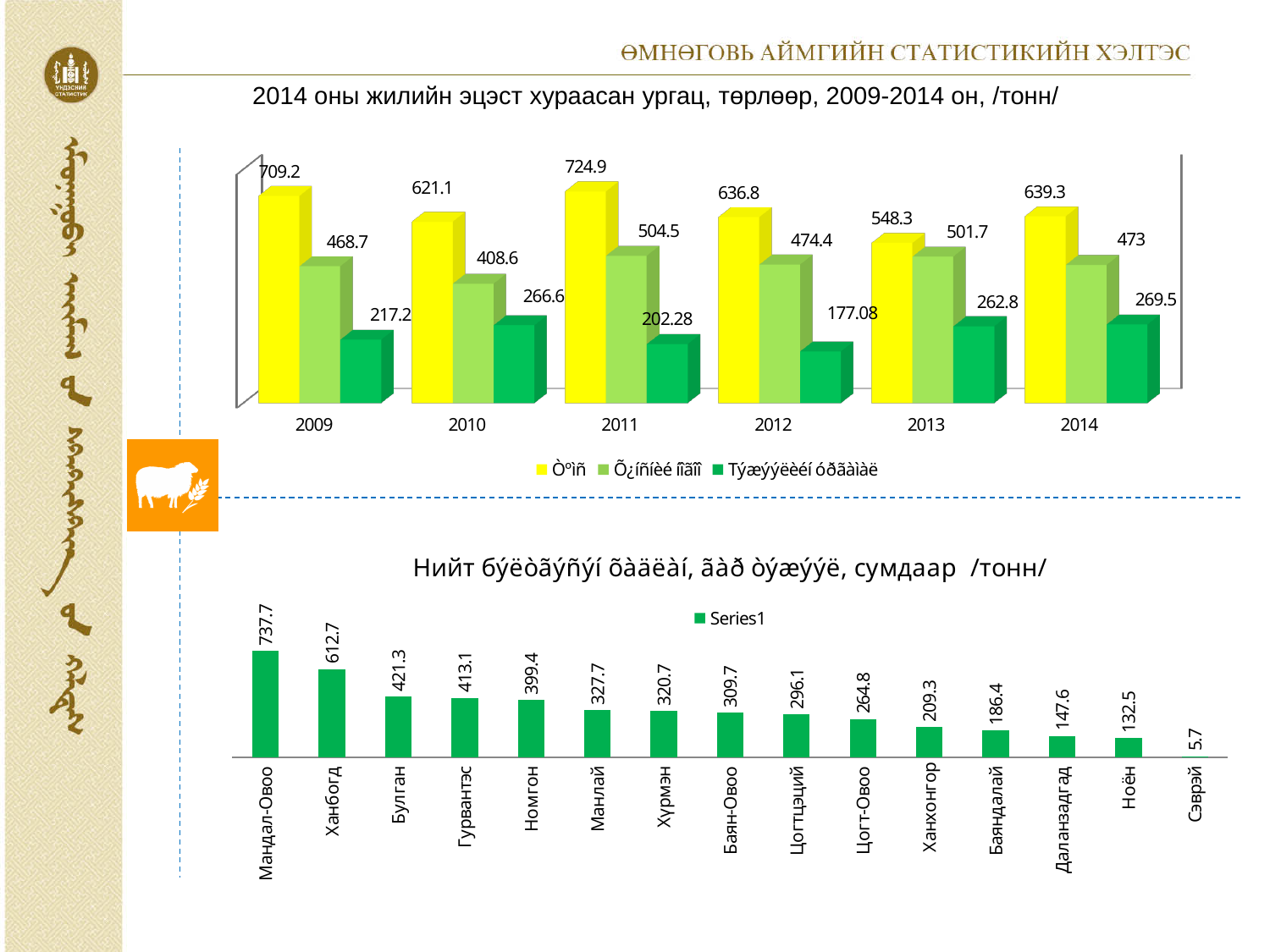
In the bottom chart (by soum), which is larger, the value for Номгон or the value for Манлай? Номгон In the top chart (2009-2014 by year), what is the value of the dark green bar for 2012? 177.08 In the top chart (2009-2014 by year), what is the difference between the yellow bar and the light green bar in 2014? 166.3 In the bottom chart (by soum), what is the value for Ханбогд? 612.7 In the top chart (2009-2014 by year), what is the value of the light green bar for 2013? 501.7 In the top chart (2009-2014 by year), which year has the highest yellow bar? 2011 In the top chart (2009-2014 by year), which year has the lowest dark green bar? 2012 In the top chart (2009-2014 by year), how many years are shown on the x axis? 6 In the bottom chart (by soum), which soum has the lowest value? Сэврэй In the top chart (2009-2014 by year), what is the value of the yellow bar for 2011? 724.9 In the bottom chart (by soum), how many soums are shown? 15 In the top chart (2009-2014 by year), how many series does the legend list? 3